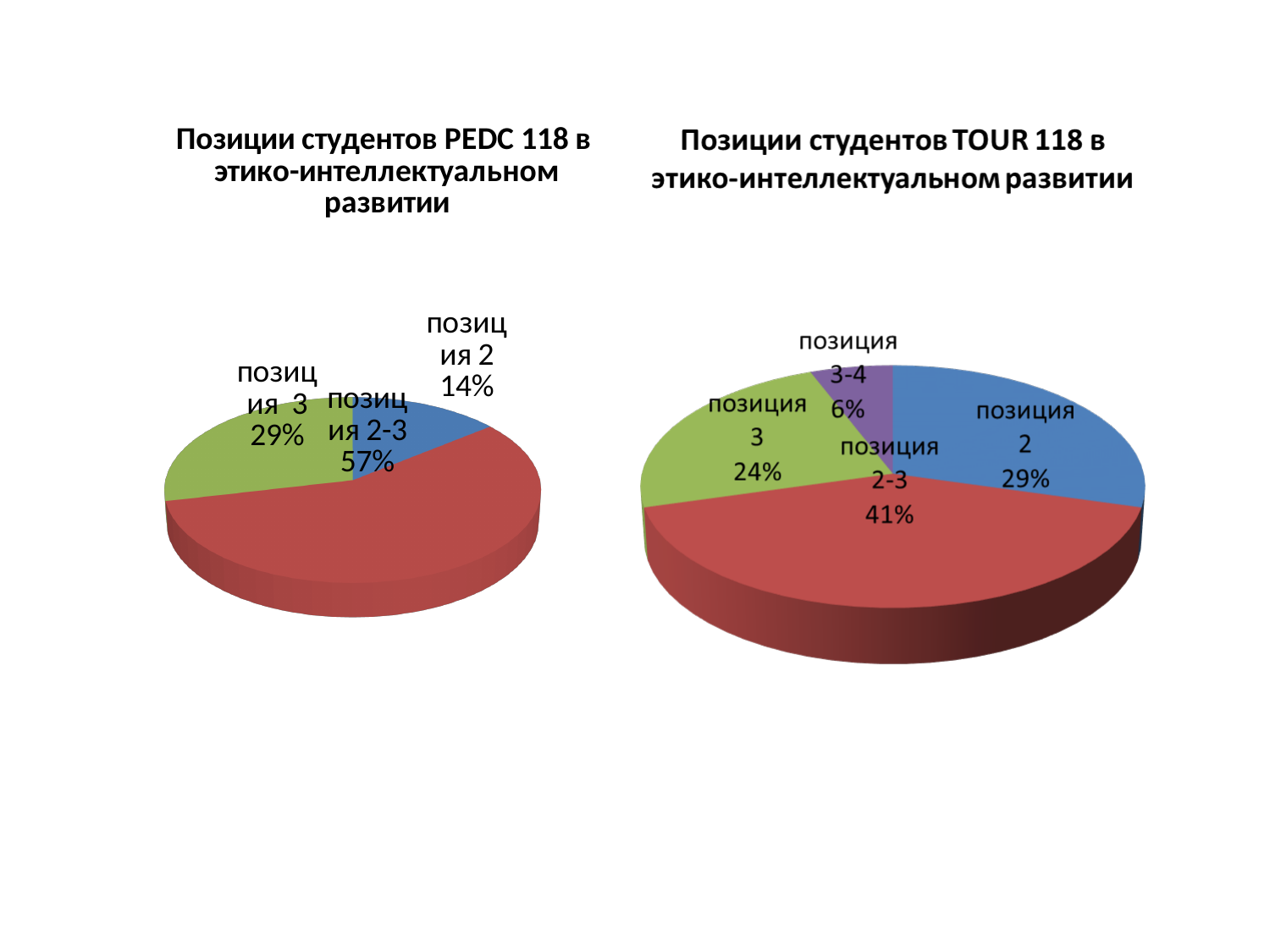
What type of chart is used on the left (PEDC 118)? Pie chart In the left chart (PEDC 118), which position has the largest share? позиция 2-3 In the right chart (TOUR 118), how many slices does the pie have? 4 In the right chart (TOUR 118), what share does 'позиция 3' have? 24% In the left chart (PEDC 118), what share does 'позиция 2-3' have? 57% In the right chart (TOUR 118), what share does 'позиция 3-4' have? 6% In the right chart (TOUR 118), what is the difference between the shares of 'позиция 2' and 'позиция 3'? 5% In the left chart (PEDC 118), how many slices does the pie have? 3 In the right chart (TOUR 118), which position has the largest share? позиция 2-3 In the left chart (PEDC 118), what share does 'позиция 2' have? 14% In the left chart (PEDC 118), which position has the smallest share? позиция 2 In the right chart (TOUR 118), which is larger: the share of 'позиция 2' or 'позиция 3-4'? позиция 2